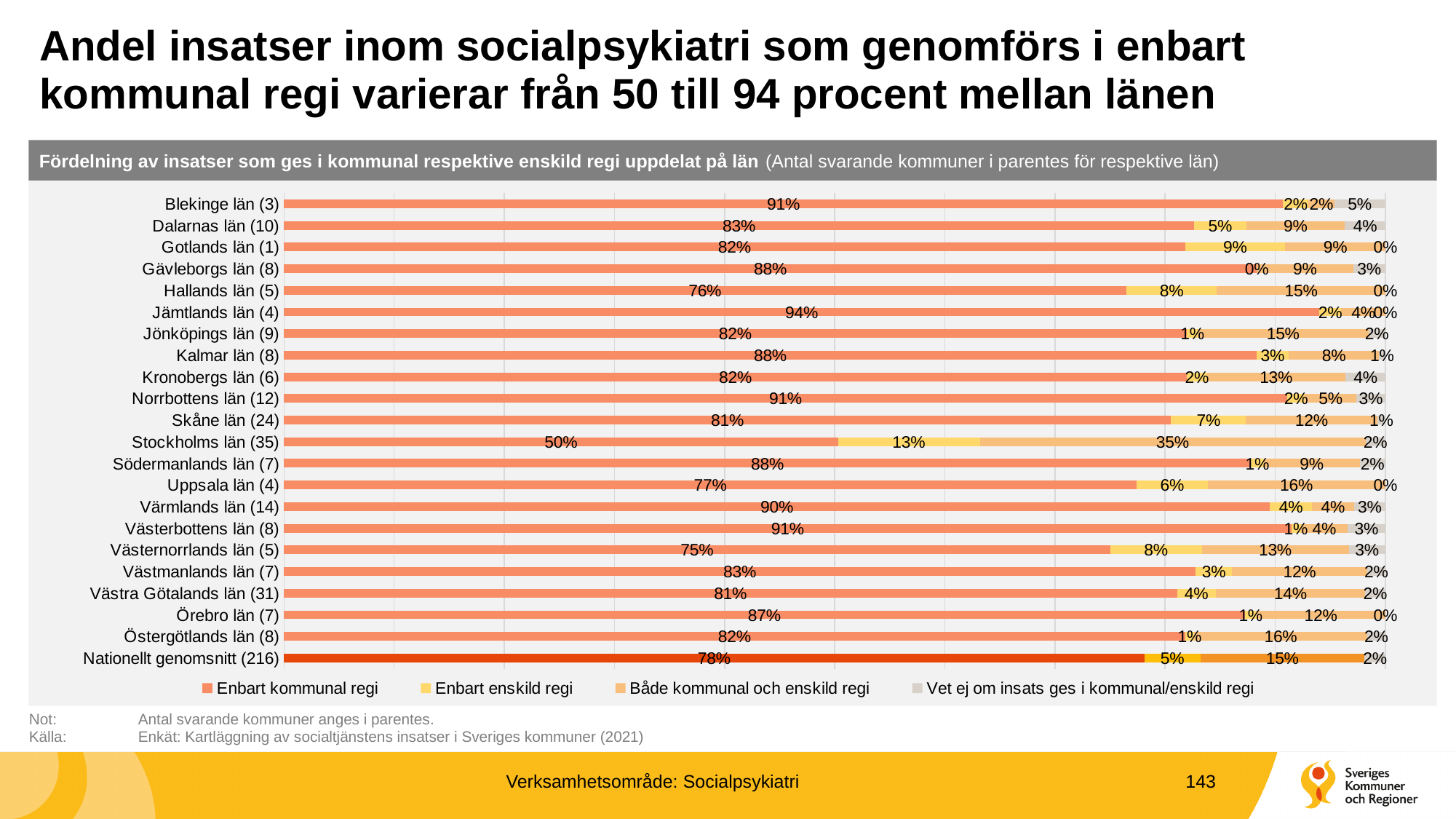
What is the difference between the Enbart kommunal regi values for Jämtlands län (4) and Stockholms län (35)? 44 percentage points Which category has the highest value for Enbart kommunal regi? Jämtlands län (4) What is the value for Enbart enskild regi for Hallands län (5)? 8% Which category has the lowest value for Enbart kommunal regi? Stockholms län (35) Which series is shown in the lightest grey colour in the legend? Vet ej om insats ges i kommunal/enskild regi What is the value for Både kommunal och enskild regi for Nationellt genomsnitt (216)? 15% What is the value for Enbart kommunal regi for Stockholms län (35)? 50% How many series does the legend list? 4 What kind of chart is shown on the slide? Stacked bar chart Which is larger: the Både kommunal och enskild regi value for Stockholms län (35) or for Uppsala län (4)? Stockholms län (35) How many categories are shown on the y axis of the chart? 22 What is the total of the stacked bar for Stockholms län (35)? 100%